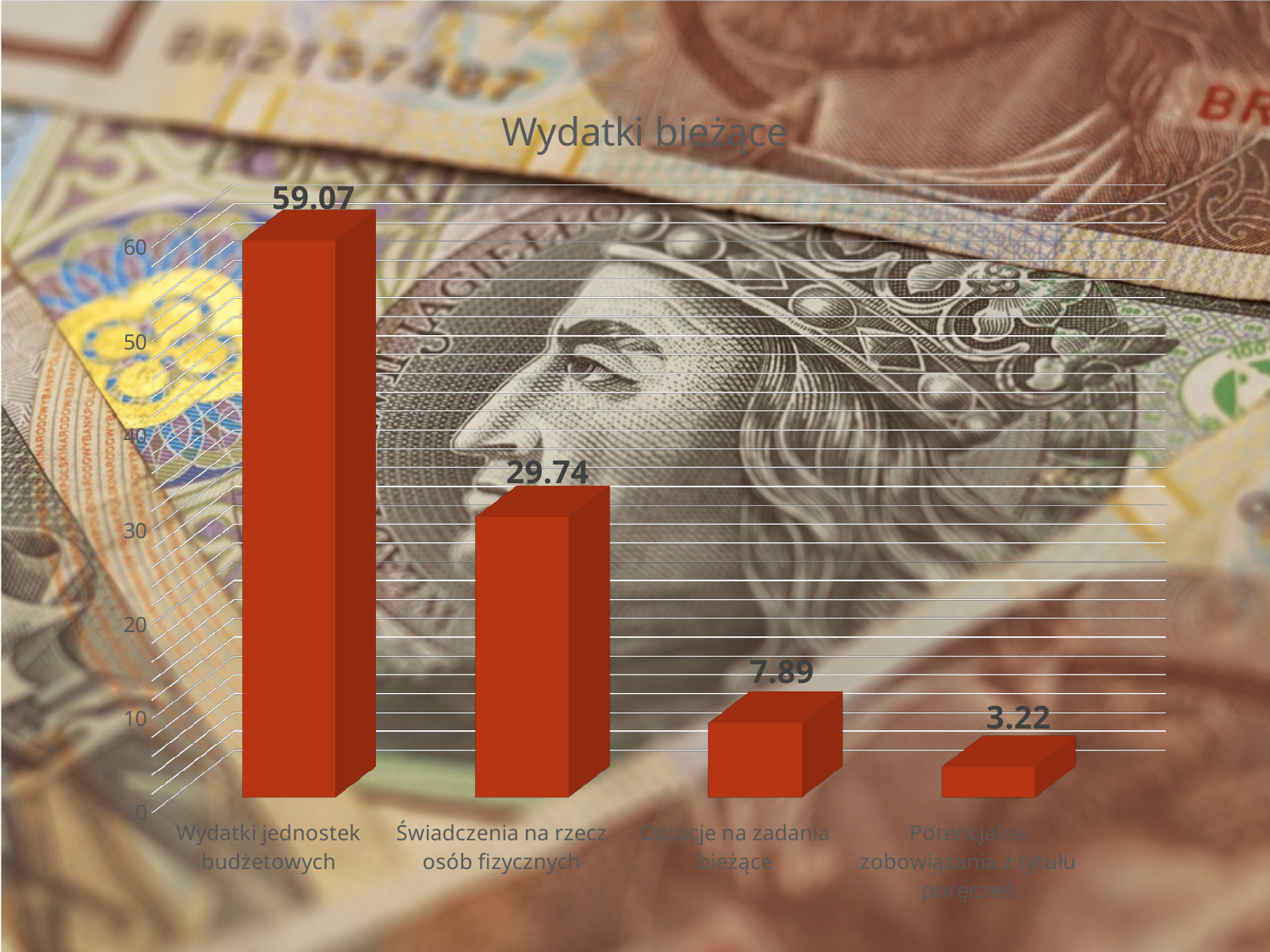
Which is larger: Dotacje na zadania bieżące or Potencjalne zobowiązania z tytułu poręczeń? Dotacje na zadania bieżące What is the value for Wydatki jednostek budżetowych? 59.07 Which category has the highest value? Wydatki jednostek budżetowych What is the difference between Wydatki jednostek budżetowych and Świadczenia na rzecz osób fizycznych? 29.33 What is the value for Potencjalne zobowiązania z tytułu poręczeń? 3.22 Which category has the lowest value? Potencjalne zobowiązania z tytułu poręczeń What is the value for Świadczenia na rzecz osób fizycznych? 29.74 Is the value for Świadczenia na rzecz osób fizycznych greater or less than 20? greater What is the value for Dotacje na zadania bieżące? 7.89 What is the title of the chart? Wydatki bieżące How many categories are shown in the chart? 4 What kind of chart is shown on the slide? bar chart